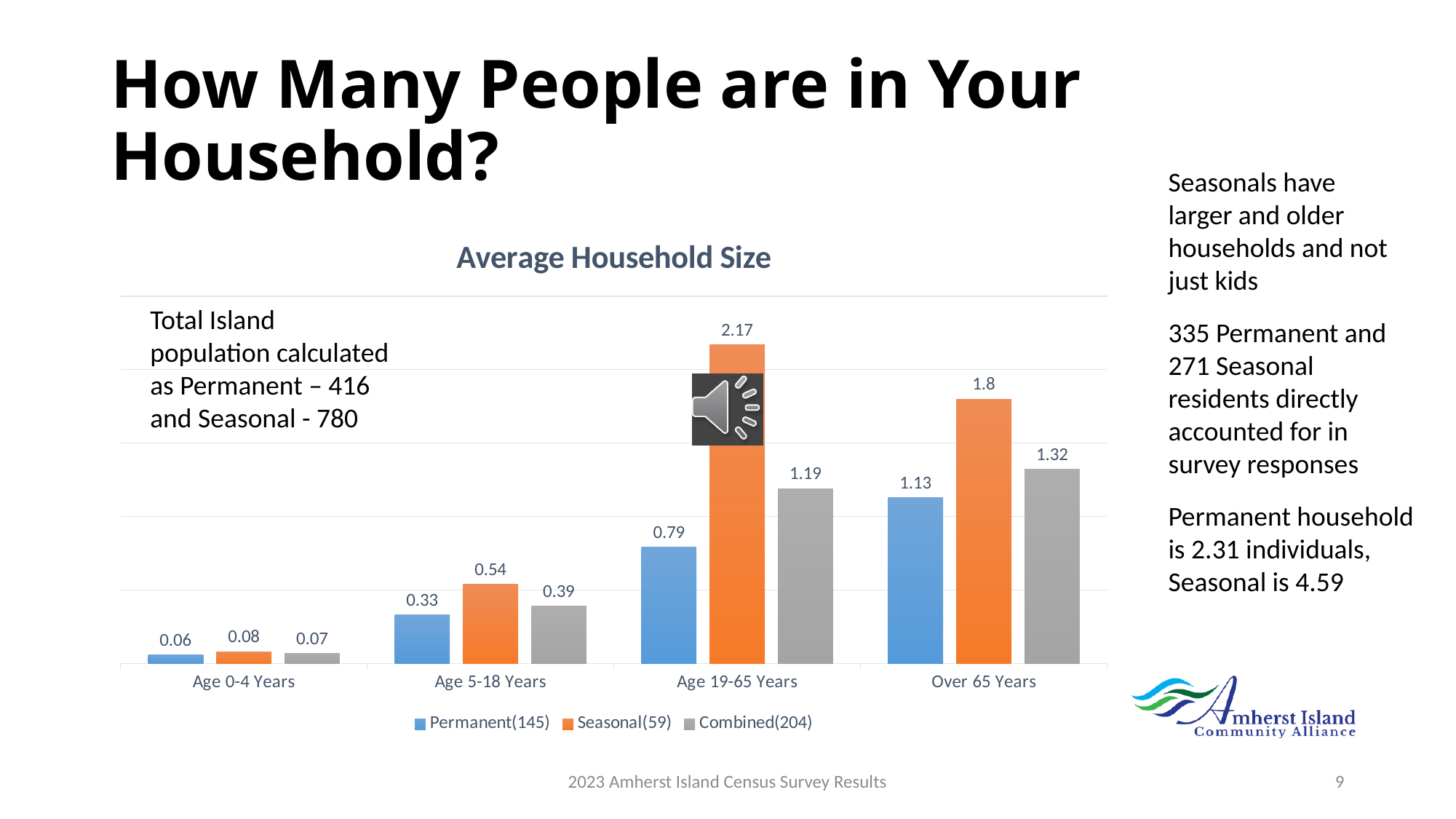
What is the Permanent(145) value for Over 65 Years? 1.13 How many series does the legend list? 3 Which is larger for Over 65 Years: the Seasonal(59) value or the Combined(204) value? Seasonal(59) Which age category has the lowest Permanent(145) value? Age 0-4 Years What is the title of the chart? Average Household Size What kind of chart is shown on the slide? Bar chart What is the difference between the Seasonal(59) and Permanent(145) values for Age 19-65 Years? 1.38 What is the Seasonal(59) value for Age 19-65 Years? 2.17 What is the Combined(204) value for Age 5-18 Years? 0.39 How many age categories are shown on the x axis? 4 Which age category has the highest Seasonal(59) value? Age 19-65 Years Do the Combined(204) values rise or fall from Age 0-4 Years to Over 65 Years? Rise